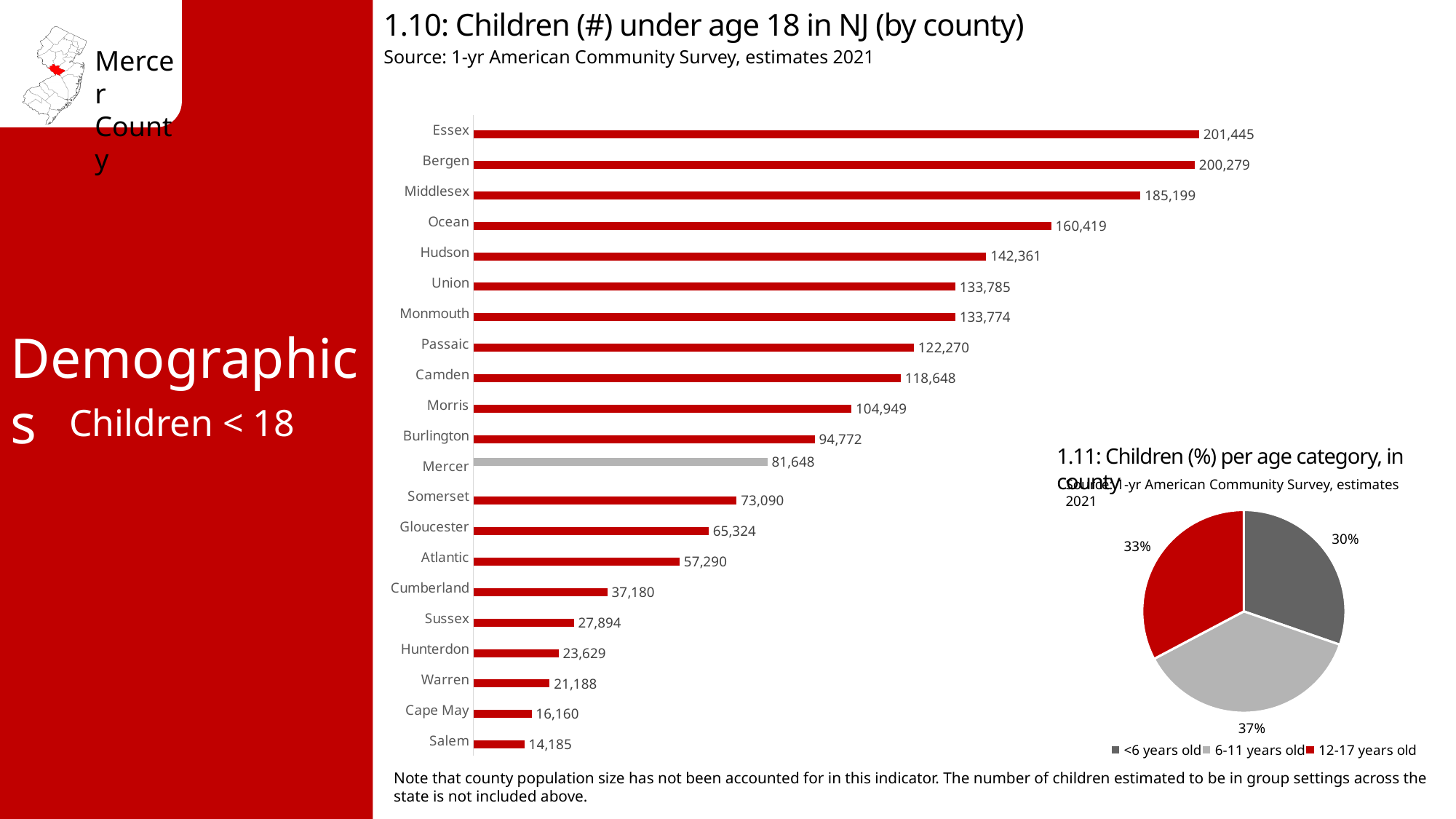
In chart 1.10, which county has more children under 18, Camden or Morris? Camden In chart 1.10, what is the difference between the number of children in Essex and Bergen counties? 1,166 In chart 1.10, which county has the highest number of children under age 18? Essex In chart 1.10, which county has the lowest number of children under age 18? Salem In chart 1.10, how many children under age 18 are in Ocean County? 160,419 What type of chart is chart 1.10? Bar chart In chart 1.10, what is the difference between the number of children in Mercer and Somerset counties? 8,558 In chart 1.11, which age category has the smallest share? <6 years old In chart 1.10, how many counties are shown? 21 In chart 1.10, how many children under age 18 are in Mercer County? 81,648 In chart 1.11, what percentage of children are 6-11 years old? 37% In chart 1.11, how many age categories does the legend list? 3